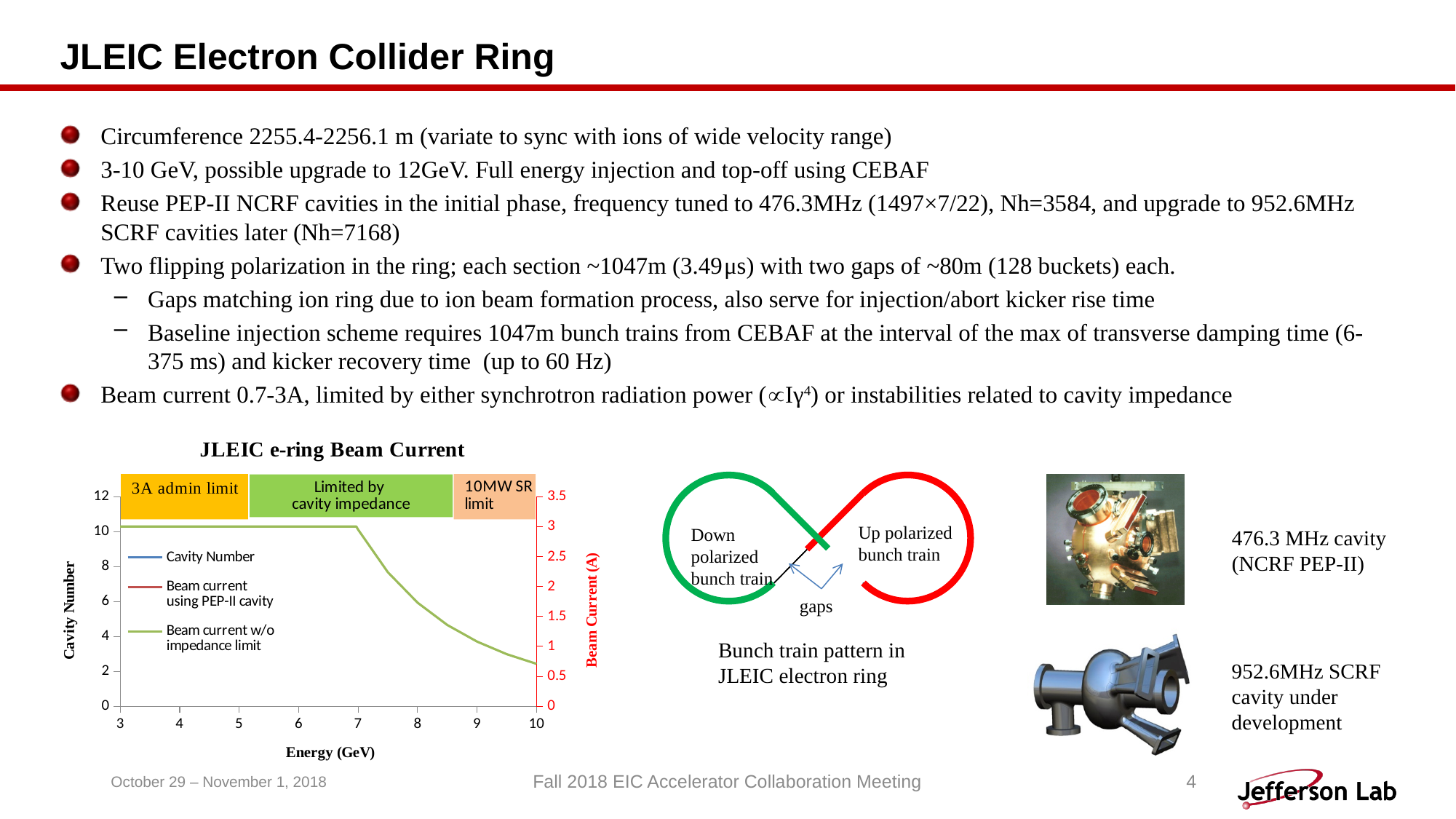
In the JLEIC e-ring Beam Current chart, is the beam current at 5 GeV greater or less than 2.5 A? greater What is the title of the chart on the slide? JLEIC e-ring Beam Current In the JLEIC e-ring Beam Current chart, is the beam current at 10 GeV greater or less than 1 A? less How many series does the legend of the JLEIC e-ring Beam Current chart list? 3 In the JLEIC e-ring Beam Current chart, is the beam current at 3 GeV greater or less than 2 A? greater What type of chart is the JLEIC e-ring Beam Current chart? line chart In the JLEIC e-ring Beam Current chart, is the beam current higher at 4 GeV or at 9 GeV? 4 GeV In the JLEIC e-ring Beam Current chart, does the beam current rise or fall as energy increases from 7 GeV to 10 GeV? fall What is the label of the x axis of the JLEIC e-ring Beam Current chart? Energy (GeV)